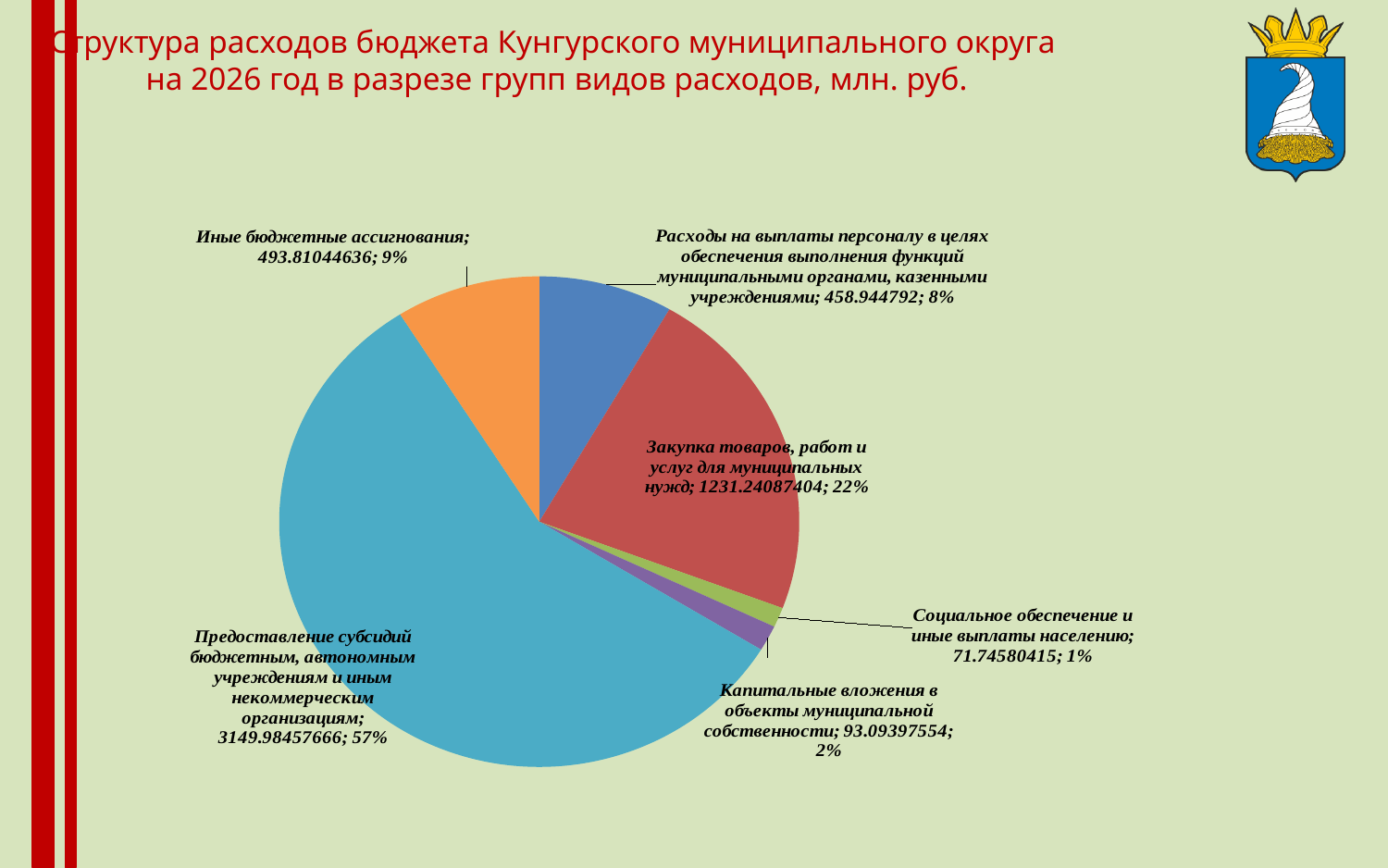
Which is larger: «Иные бюджетные ассигнования» or «Расходы на выплаты персоналу в целях обеспечения выполнения функций муниципальными органами, казенными учреждениями»? Иные бюджетные ассигнования What share of the pie does «Предоставление субсидий бюджетным, автономным учреждениям и иным некоммерческим организациям» represent? 57% What is the title of the chart on the slide? Структура расходов бюджета Кунгурского муниципального округа на 2026 год в разрезе групп видов расходов, млн. руб. What share of the pie does «Капитальные вложения в объекты муниципальной собственности» represent? 2% What kind of chart is shown on the slide? pie chart Which category has the smallest value? Социальное обеспечение и иные выплаты населению What is the value for «Закупка товаров, работ и услуг для муниципальных нужд»? 1231.24087404 What is the difference between the values for «Капитальные вложения в объекты муниципальной собственности» and «Социальное обеспечение и иные выплаты населению»? 21.34817139 What is the value for «Иные бюджетные ассигнования»? 493.81044636 How many slices does the pie chart have? 6 What is the value for «Социальное обеспечение и иные выплаты населению»? 71.74580415 Which category has the largest value? Предоставление субсидий бюджетным, автономным учреждениям и иным некоммерческим организациям